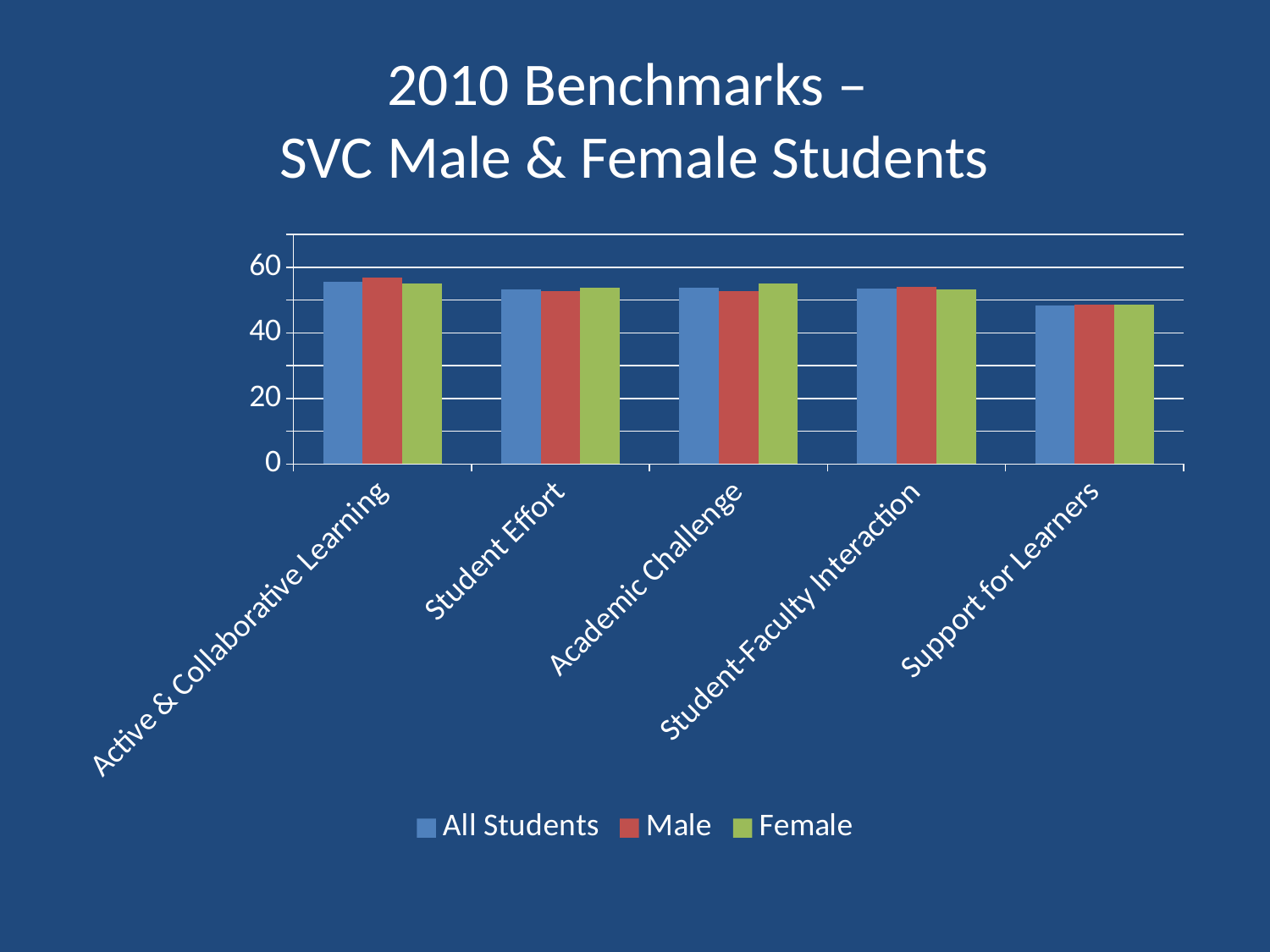
Which series are listed in the legend? All Students, Male, Female Which category has the highest value for the Male series? Active & Collaborative Learning How many benchmark categories are shown on the x axis? 5 For Active & Collaborative Learning, which is larger: the Male value or the Female value? Male Is the Male value for Active & Collaborative Learning greater or less than 40? greater For the All Students series, which is larger: Active & Collaborative Learning or Support for Learners? Active & Collaborative Learning How many series does the legend list? 3 Which category has the lowest value for the Female series? Support for Learners What kind of chart is shown on the slide? bar chart What is the title of the chart? 2010 Benchmarks – SVC Male & Female Students Is the All Students value for Support for Learners greater or less than 60? less Which category has the lowest value for the Male series? Support for Learners